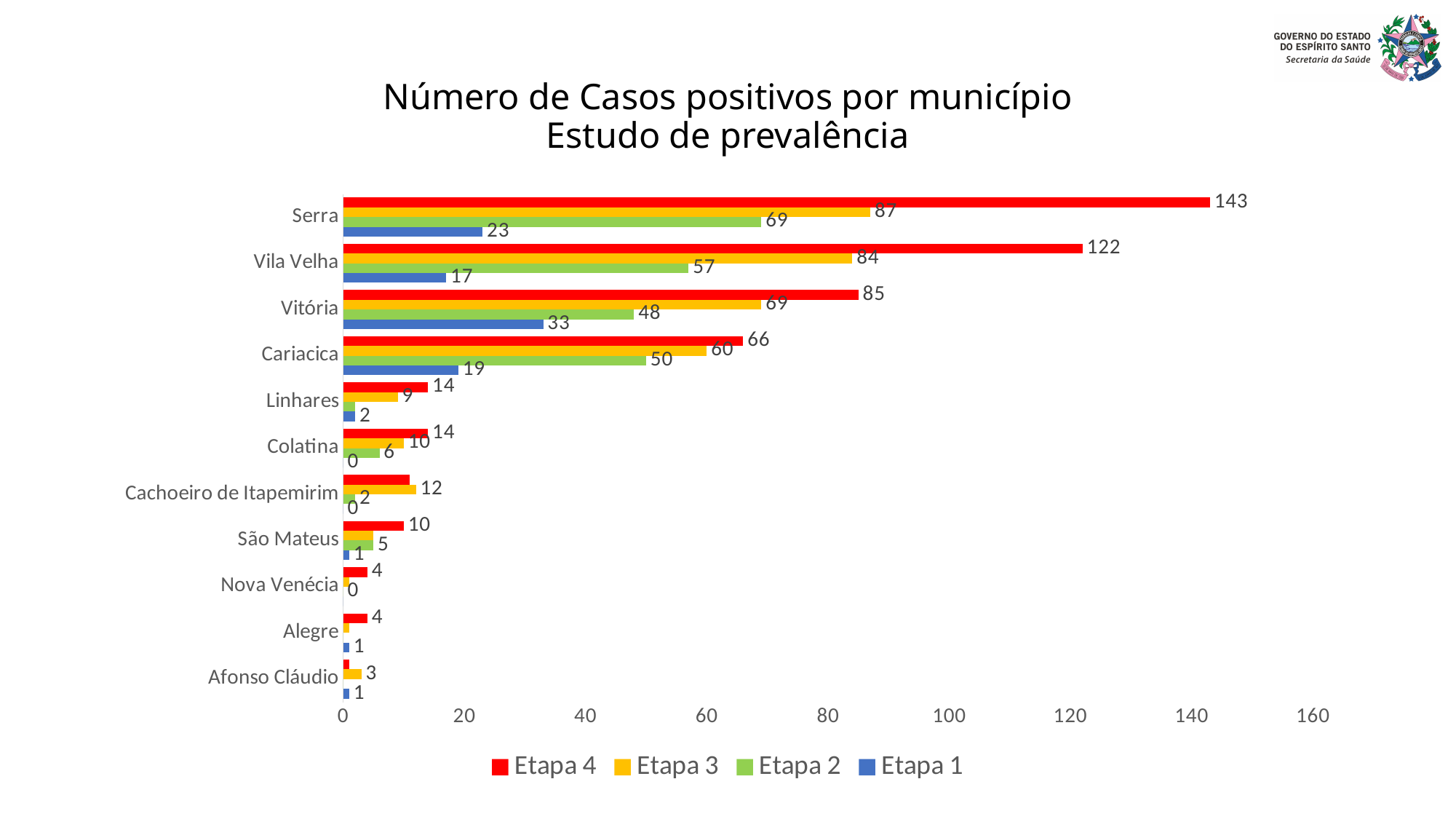
How many municipalities are shown on the chart? 11 What is the Etapa 3 value for Vila Velha? 84 Which municipality has the highest Etapa 1 value? Vitória What kind of chart is shown on the slide? bar chart How many series does the legend list? 4 What is the Etapa 1 value for Vitória? 33 What is the Etapa 4 value for Serra? 143 What is the Etapa 2 value for Cariacica? 50 Is the Etapa 4 value for Cachoeiro de Itapemirim greater or less than 20? less What is the difference between the Etapa 4 values for Serra and Vila Velha? 21 Which is larger: the Etapa 2 value for Vitória or the Etapa 2 value for Vila Velha? Vila Velha Which municipality has the highest Etapa 4 value? Serra